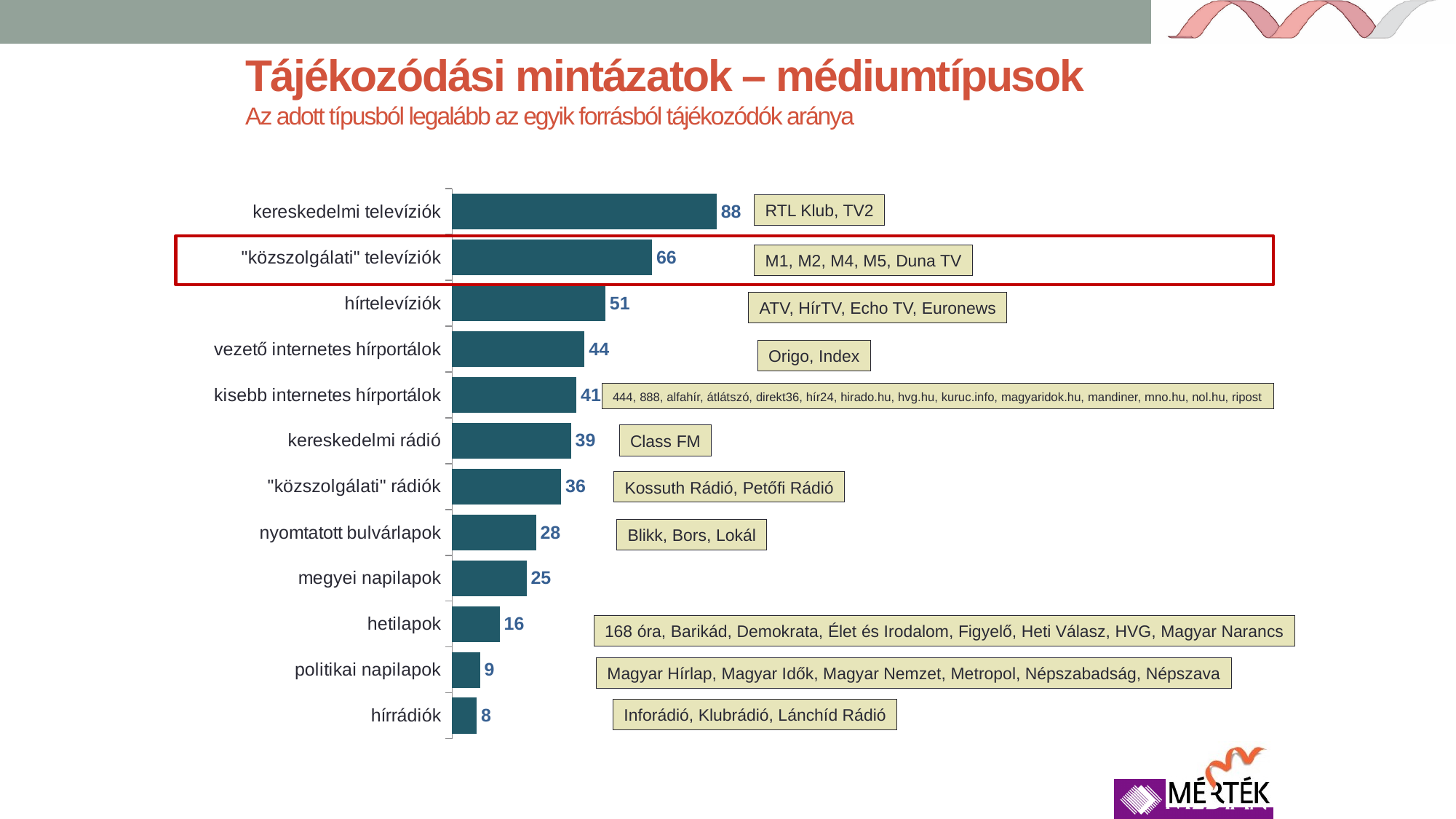
What is the value for "közszolgálati" televíziók? 66 Which category is highlighted with a red box on the slide? "közszolgálati" televíziók What is the value for kereskedelmi televíziók? 88 How many categories are shown in the chart? 12 What is the difference between the values for kereskedelmi televíziók and "közszolgálati" televíziók? 22 What is the difference between the values for hírtelevíziók and kisebb internetes hírportálok? 10 Which is larger, the value for kereskedelmi rádió or the value for "közszolgálati" rádiók? kereskedelmi rádió Which category has the lowest value? hírrádiók What is the value for vezető internetes hírportálok? 44 What is the value for hetilapok? 16 Which category has the highest value? kereskedelmi televíziók What kind of chart is shown on the slide? bar chart